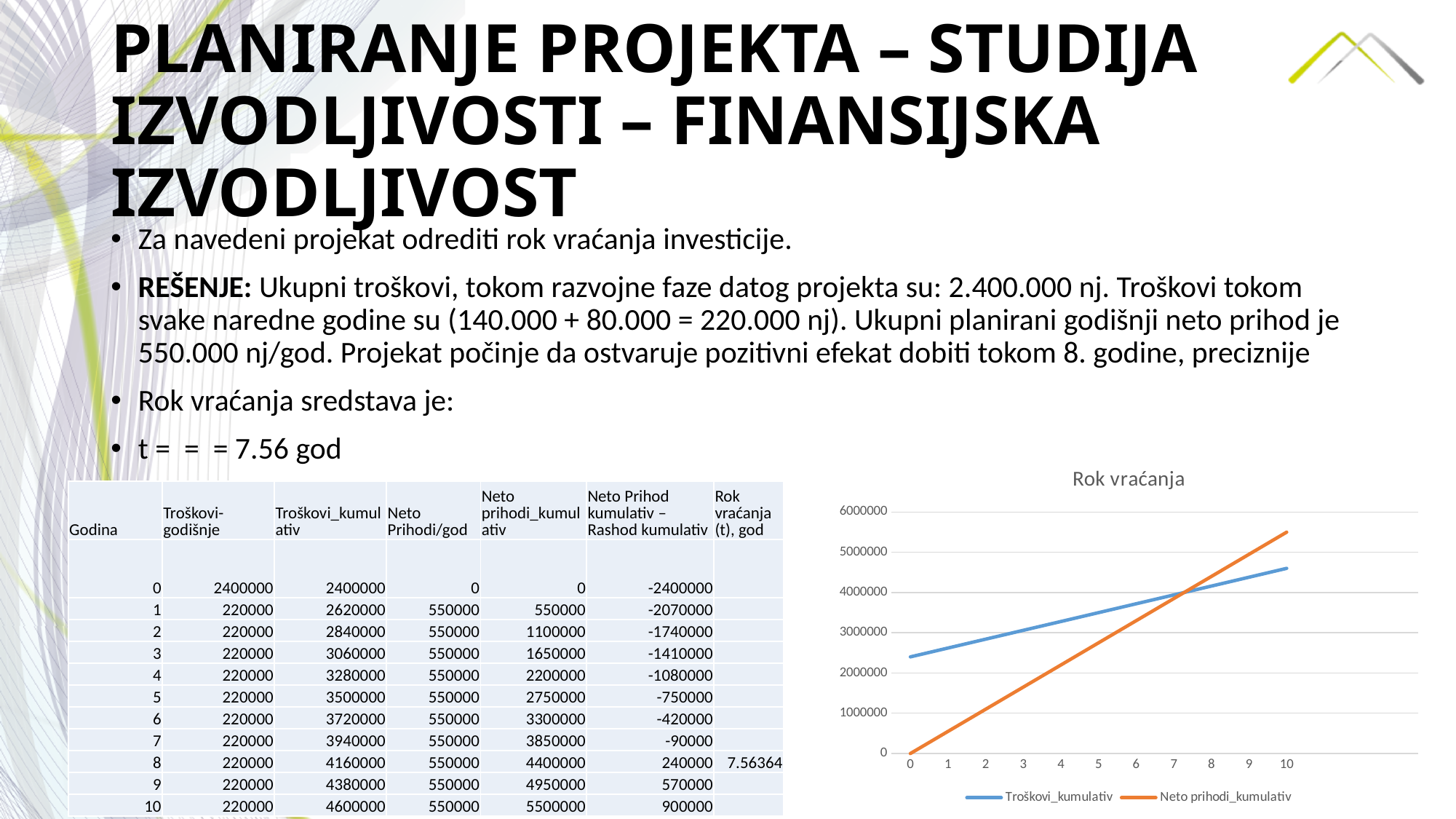
In the "Rok vraćanja" chart, what is the value of Neto prihodi_kumulativ at year 0? 0 How many points (years) are marked along the x axis of the "Rok vraćanja" chart? 11 In the "Rok vraćanja" chart, which series has the larger value at year 2? Troškovi_kumulativ In the "Rok vraćanja" chart, is the value of Troškovi_kumulativ at year 10 greater or less than 5000000? less In the "Rok vraćanja" chart, what colour is the Neto prihodi_kumulativ line? orange What is the title of the chart on the right side of the slide? Rok vraćanja How many series does the legend of the "Rok vraćanja" chart list? 2 In the "Rok vraćanja" chart, which series has the larger value at year 10? Neto prihodi_kumulativ In the "Rok vraćanja" chart, is the value of Troškovi_kumulativ at year 0 greater or less than 2000000? greater In the "Rok vraćanja" chart, does the Neto prihodi_kumulativ line rise or fall from year 0 to year 10? rise In the "Rok vraćanja" chart, is the value of Neto prihodi_kumulativ at year 10 greater or less than 5000000? greater What kind of chart is shown under the title "Rok vraćanja"? line chart